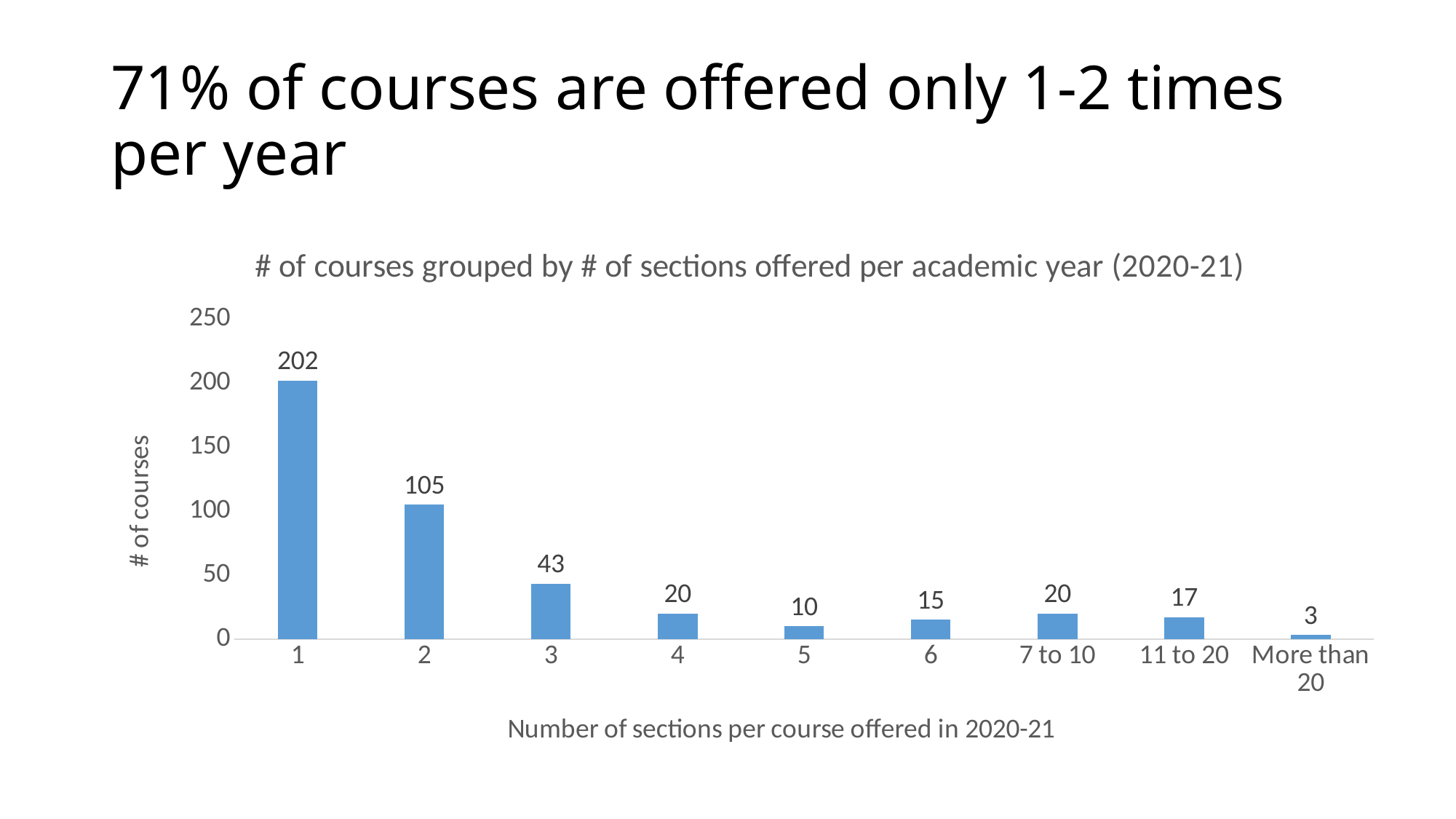
What is the label of the y axis? # of courses What is the difference between the number of courses with 1 section and the number with 2 sections? 97 How many courses were offered with 1 section in 2020-21? 202 Which has more courses: 3 sections or 4 sections? 3 sections What is the title of the chart? # of courses grouped by # of sections offered per academic year (2020-21) Is the value for 5 sections greater or less than 50? less How many courses had 11 to 20 sections? 17 What kind of chart is shown on the slide? Bar chart Which category has the highest number of courses? 1 What is the number of courses with 2 sections? 105 Which category has the lowest number of courses? More than 20 How many categories are shown on the x axis? 9